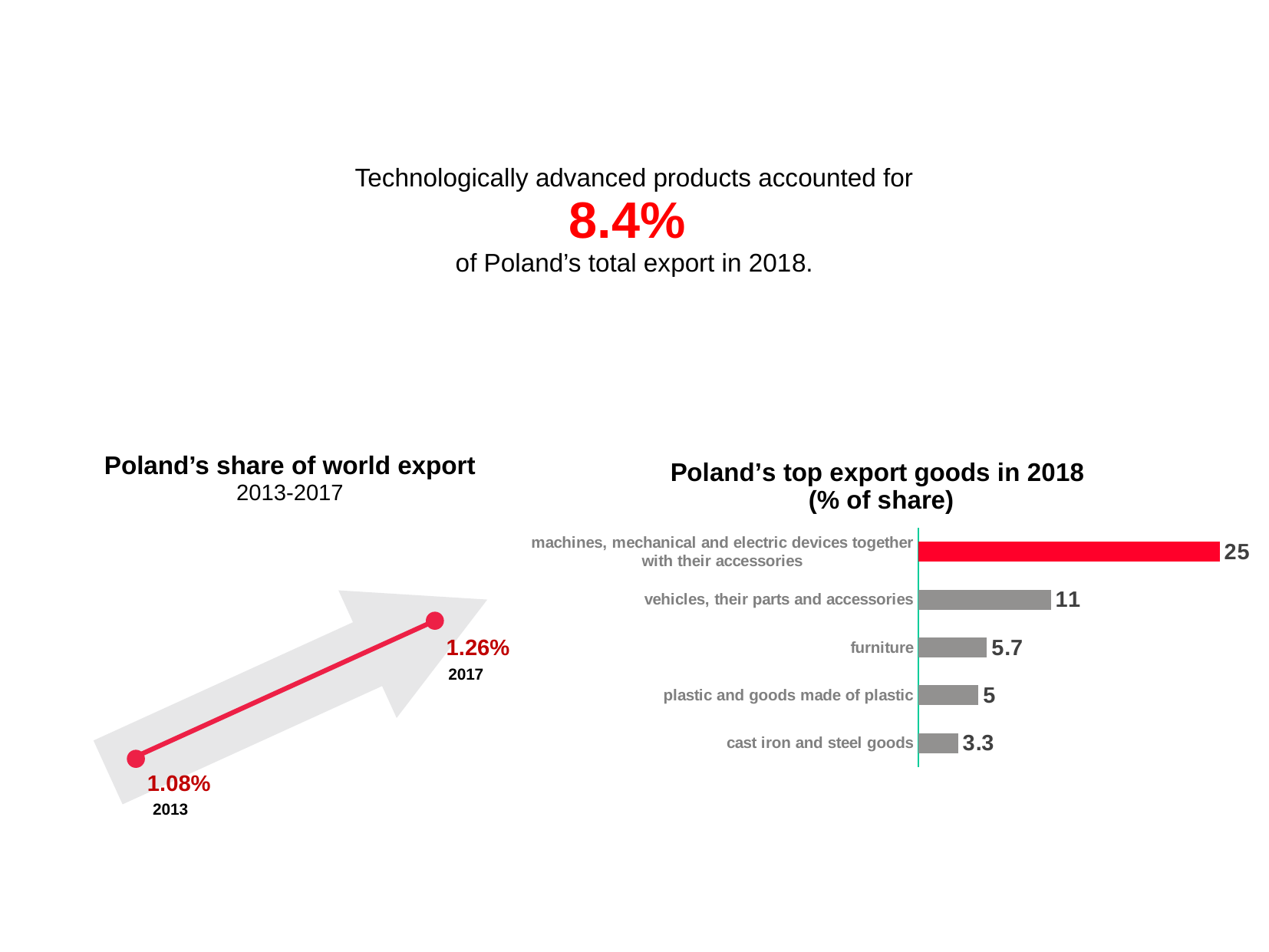
In the 'Poland's share of world export' chart, what was Poland's share in 2013? 1.08% What kind of chart is 'Poland's top export goods in 2018'? bar chart In the 'Poland's share of world export' chart, what was Poland's share in 2017? 1.26% In the 'Poland's share of world export' chart, does the value rise or fall from 2013 to 2017? rise How many categories are shown in the 'Poland's top export goods in 2018' chart? 5 In the 'Poland's top export goods in 2018' chart, what is the value for cast iron and steel goods? 3.3 In the 'Poland's top export goods in 2018' chart, which category has the lowest value? cast iron and steel goods In the 'Poland's top export goods in 2018' chart, which category has the highest value? machines, mechanical and electric devices together with their accessories In the 'Poland's top export goods in 2018' chart, what is the value for vehicles, their parts and accessories? 11 In the 'Poland's top export goods in 2018' chart, what is the value for furniture? 5.7 In the 'Poland's top export goods in 2018' chart, which is larger: furniture or plastic and goods made of plastic? furniture In the 'Poland's top export goods in 2018' chart, what is the difference between the values for machines, mechanical and electric devices and vehicles, their parts and accessories? 14